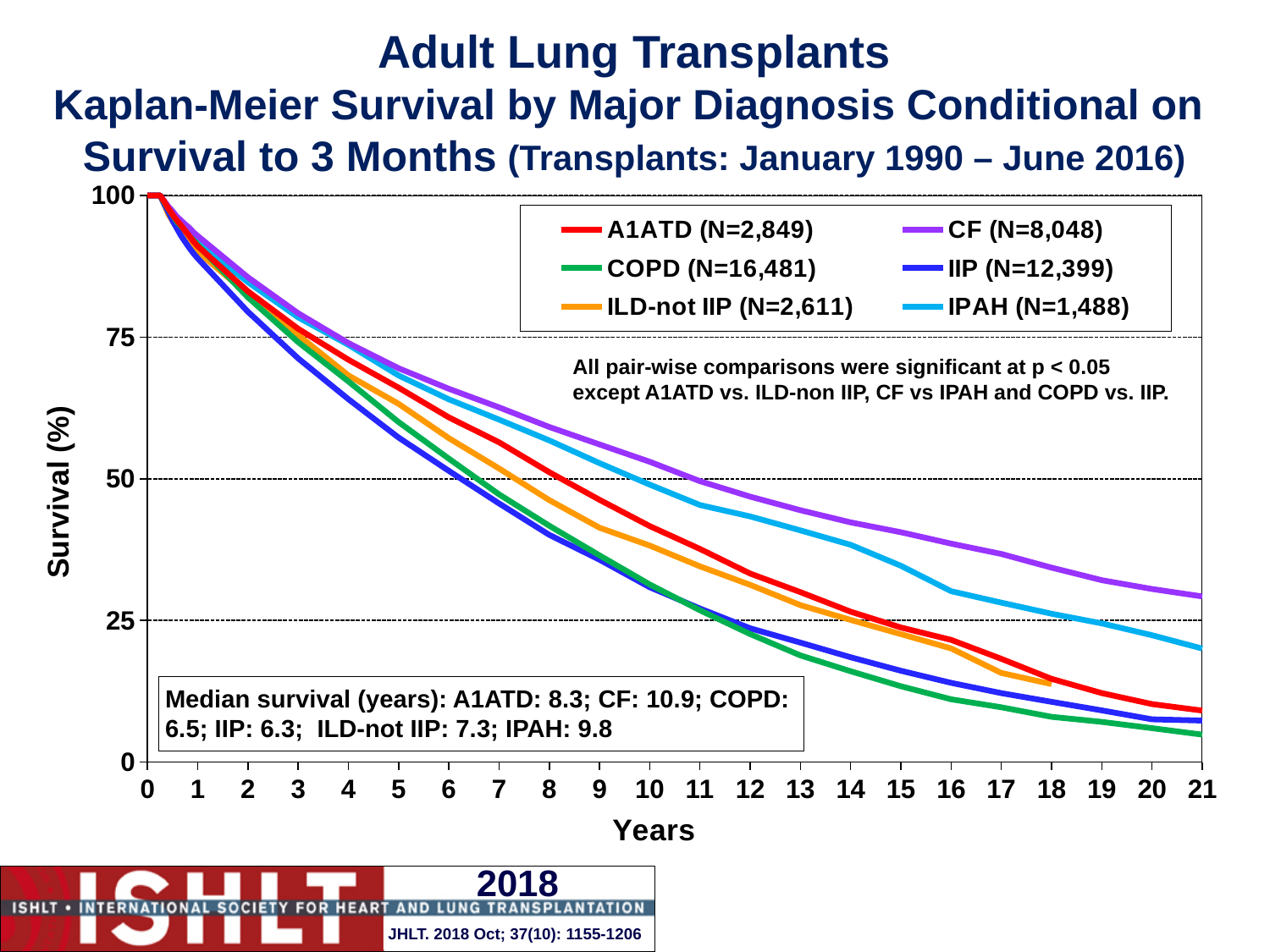
At 21 years, which curve shows higher survival, CF or IPAH? CF Which diagnosis group has the highest median survival? CF According to the legend, what is the N for the COPD group? 16,481 How many diagnosis groups (series) does the legend list? 6 What kind of chart is shown on the slide? line chart Do the survival curves rise or fall as years increase? fall Is the survival value for CF at 21 years greater or less than 25? greater What is the median survival in years for IPAH, as stated in the text box? 9.8 What is the difference in median survival (years) between CF and IIP? 4.6 Is the survival value for COPD at 21 years greater or less than 25? less Which diagnosis group has the lowest median survival? IIP What is the median survival in years for CF, as stated in the text box? 10.9